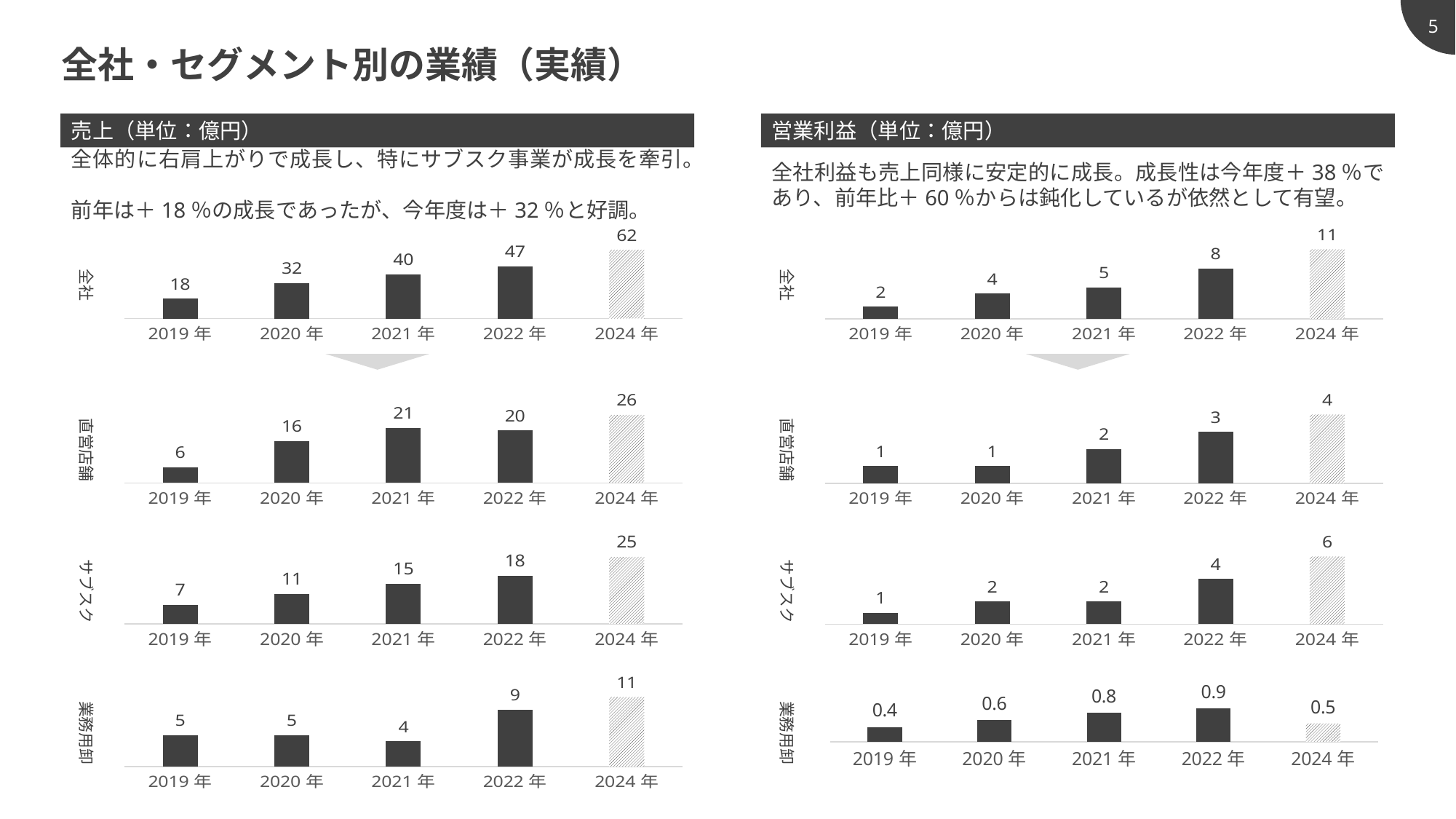
In the 売上 業務用卸 chart, which year has the lowest value? 2021 年 In the 売上 全社 chart, what is the value for 2022 年? 47 In the 売上 サブスク chart, what is the difference between the 2024 年 and 2022 年 values? 7 In the 売上 直営店舗 chart, what is the difference between the 2021 年 and 2019 年 values? 15 In the 営業利益 直営店舗 chart, do the values rise or fall from 2019 年 to 2024 年? rise In the 営業利益 業務用卸 chart, what is the value for 2022 年? 0.9 In the 売上 全社 chart, which year has the highest value? 2024 年 In the 営業利益 全社 chart, what is the value for 2020 年? 4 How many years are shown on the x axis of the 売上 直営店舗 chart? 5 What unit is stated in the header of the 売上 section? 億円 What kind of chart is used for 営業利益 サブスク? bar chart In the 営業利益 業務用卸 chart, which is larger, the value for 2021 年 or 2024 年? 2021 年